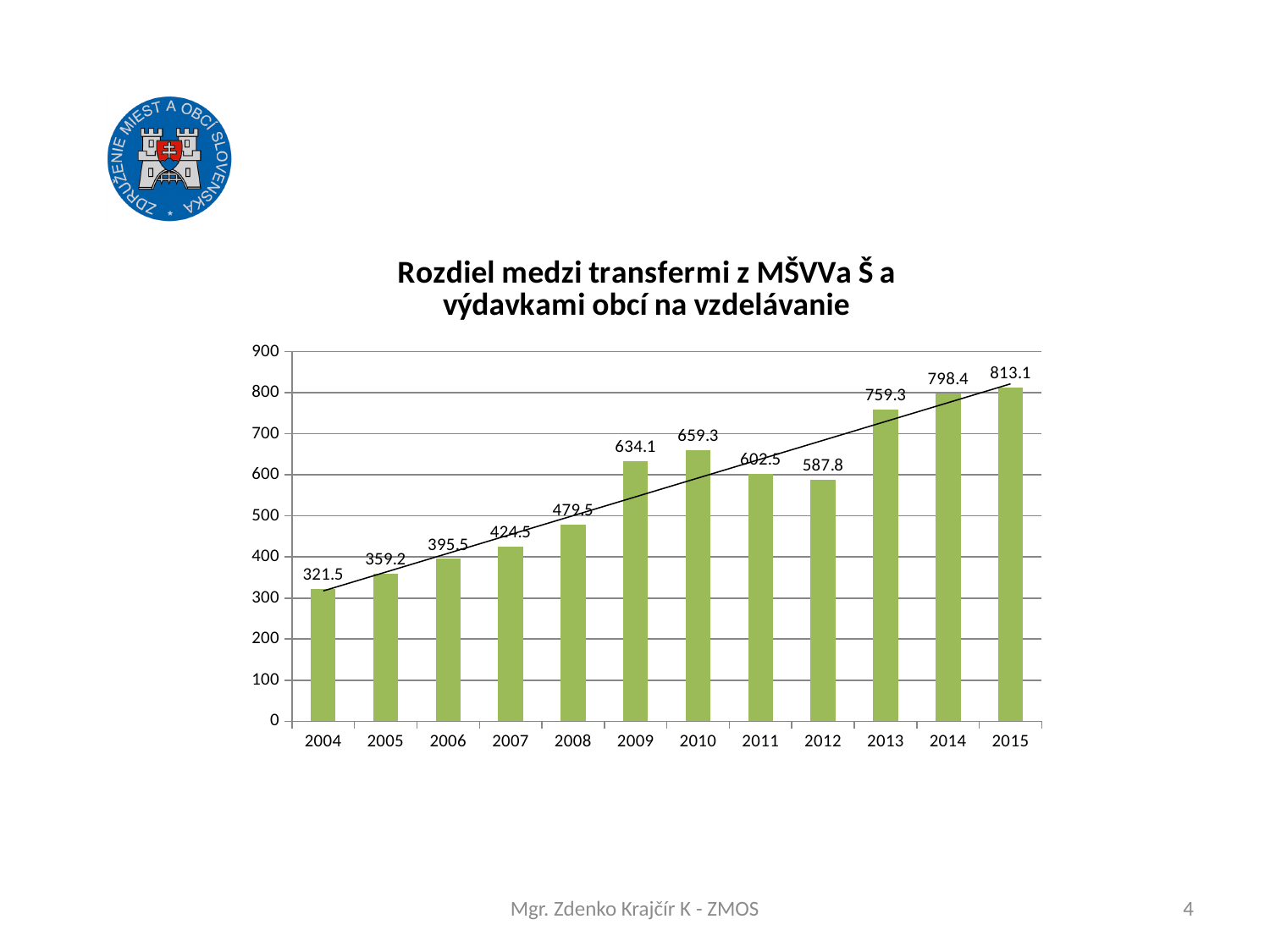
Which year has the highest value? 2015 Is the value for 2008 greater or less than 500? less What is the title of the chart? Rozdiel medzi transfermi z MŠVVa Š a výdavkami obcí na vzdelávanie Which is larger, the value for 2011 or the value for 2012? 2011 What is the value for 2009? 634.1 What kind of chart is this? bar chart How many years are shown on the x axis? 12 What is the difference between the values for 2010 and 2011? 56.8 What is the value for 2004? 321.5 What is the value for 2012? 587.8 What is the difference between the values for 2015 and 2014? 14.7 Which year has the lowest value? 2004